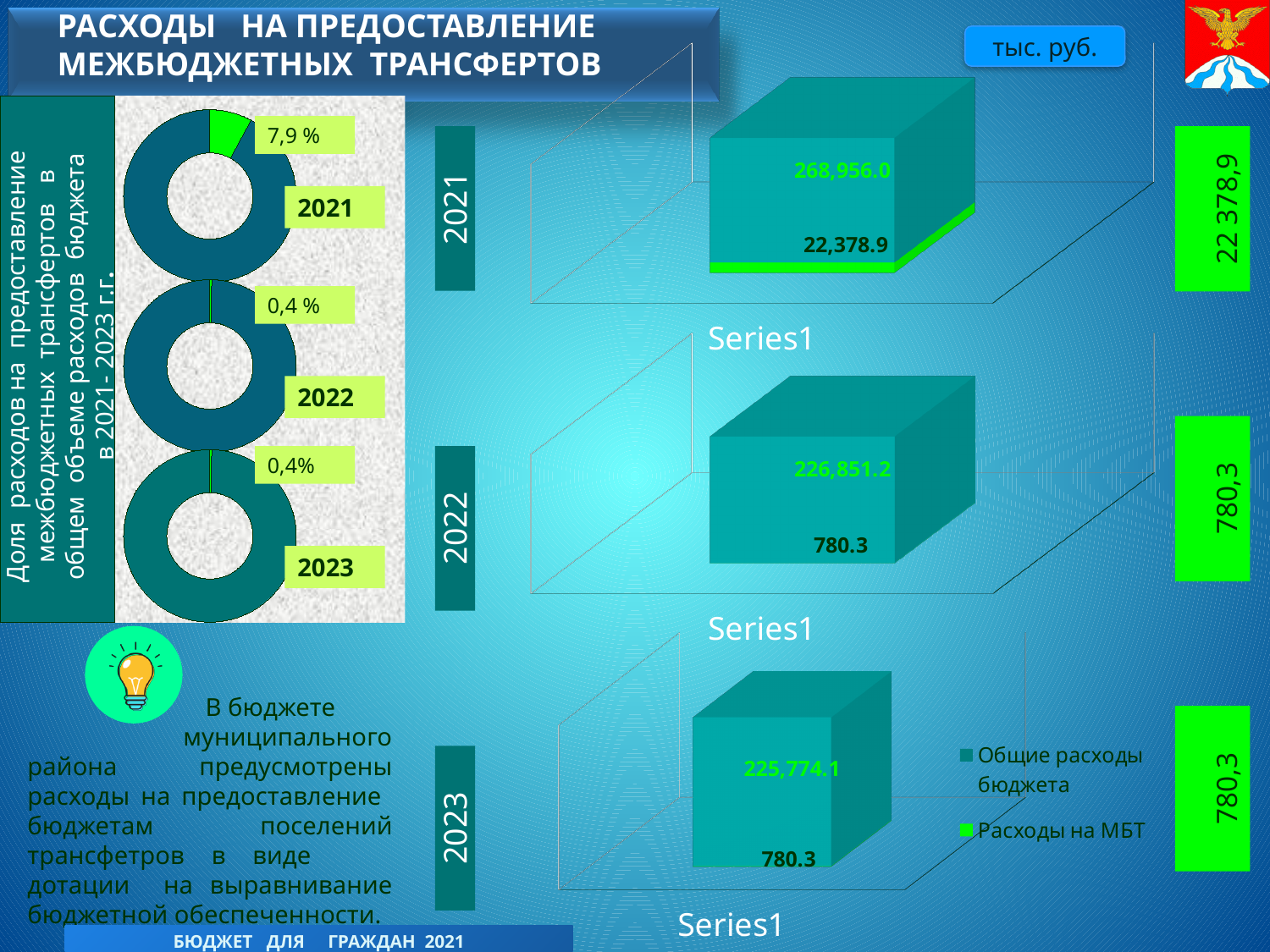
In the 2023 bar chart, what is the value labelled for Общие расходы бюджета? 225,774.1 Across the three bar charts, which year shows the highest value for Расходы на МБТ? 2021 In the donut chart for 2022, what share is shown for the МБТ expenses? 0,4 % Across the three bar charts, which year shows the highest value for Общие расходы бюджета? 2021 In the 2023 bar chart, what is the value labelled for Расходы на МБТ? 780.3 How many series does the legend of the bar charts list? 2 Is the value for Общие расходы бюджета larger in the 2022 chart or the 2023 chart? 2022 In the 2021 bar chart, what is the value labelled for Расходы на МБТ? 22,378.9 What is the difference between Общие расходы бюджета in the 2022 chart and in the 2023 chart? 1,077.1 In the donut chart for 2021, what share is shown for the МБТ expenses? 7,9 % In the 2022 bar chart, what is the value labelled for Общие расходы бюджета? 226,851.2 In the 2021 bar chart, what is the value labelled for Общие расходы бюджета? 268,956.0